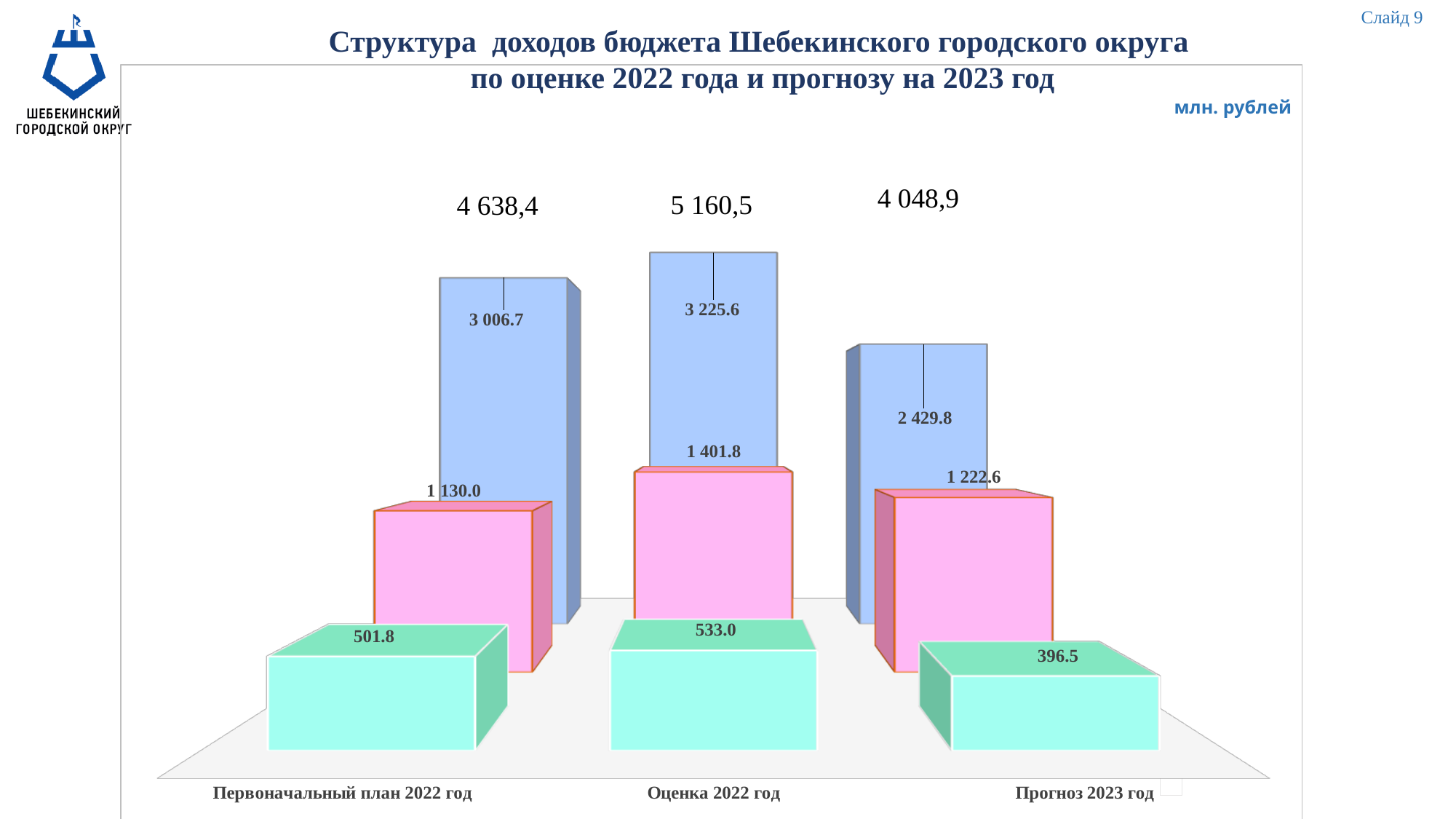
Which category has the lowest value for the teal bars? Прогноз 2023 год Which is larger: the pink bar for "Оценка 2022 год" or the pink bar for "Прогноз 2023 год"? Оценка 2022 год What kind of chart is shown on the slide? bar chart What unit of measurement is stated on the chart? млн. рублей What is the value of the blue bar for "Оценка 2022 год"? 3 225.6 How many categories are shown along the x axis of the chart? 3 Which category has the lowest total printed above its bars? Прогноз 2023 год What is the value of the pink bar for "Первоначальный план 2022 год"? 1 130.0 What is the value of the teal bar for "Прогноз 2023 год"? 396.5 Which category has the highest value for the blue bars? Оценка 2022 год What is the difference between the blue bar values for "Оценка 2022 год" and "Прогноз 2023 год"? 795.8 What total is printed above the bars for "Оценка 2022 год"? 5 160,5